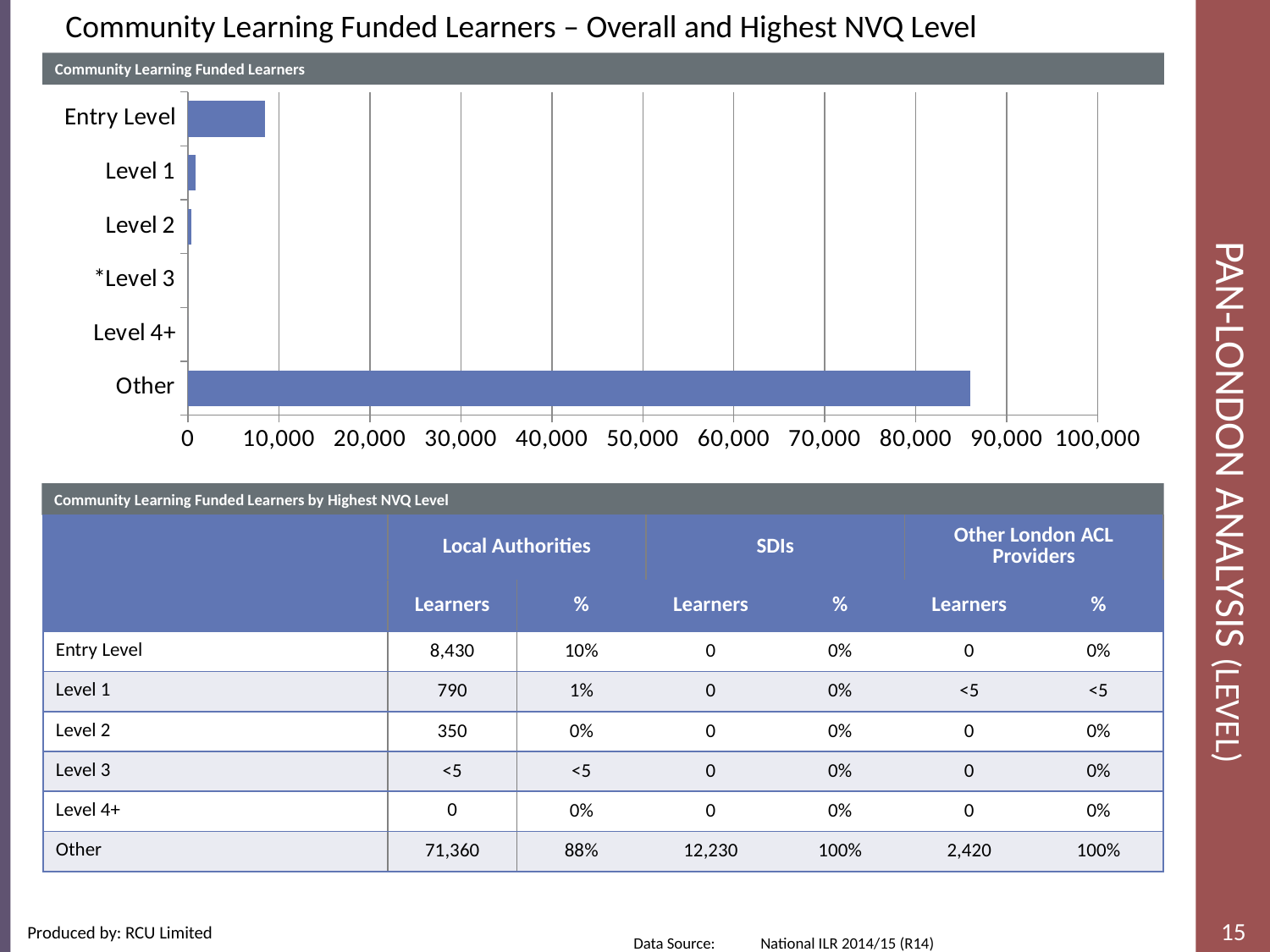
Which category has the highest value in the chart? Other What is the highest value shown on the chart's horizontal axis? 100,000 Which is larger in the chart, Entry Level or Level 1? Entry Level Is the value for Entry Level greater or less than 10,000? less What kind of chart is shown on the slide? bar chart Is the value for Other greater or less than 80,000? greater Which is larger in the chart, Other or Entry Level? Other How many categories are plotted in the chart? 6 What is the title of the chart? Community Learning Funded Learners Is the value for Level 1 greater or less than 10,000? less